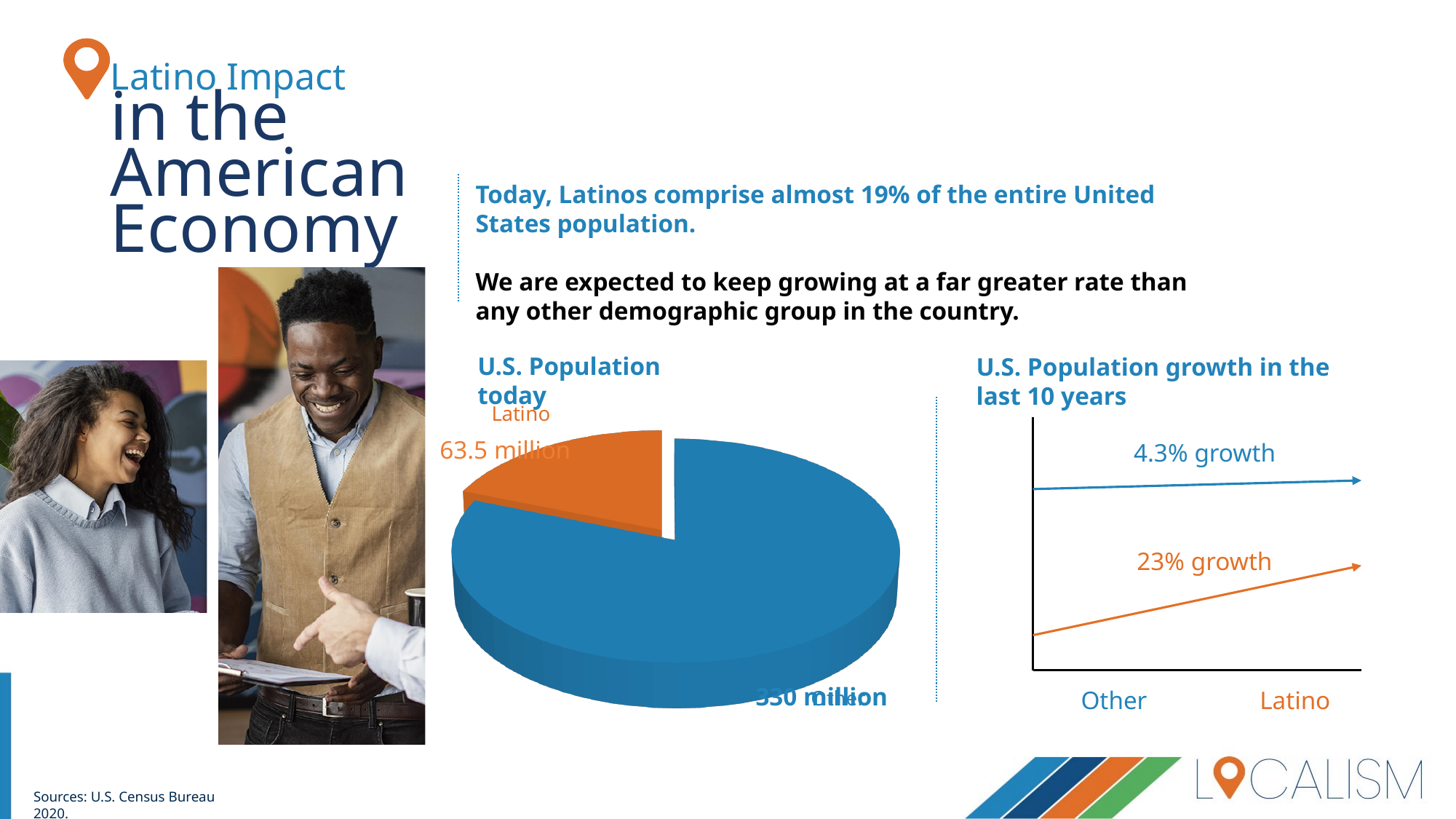
In the "U.S. Population growth in the last 10 years" chart, what growth is shown for Other? 4.3% growth In the "U.S. Population today" pie chart, which slice is the largest? Other How many lines are plotted in the "U.S. Population growth in the last 10 years" chart? 2 In the "U.S. Population today" pie chart, what value is shown for the blue slice? 330 million What kind of chart is the "U.S. Population today" chart? Pie chart In the "U.S. Population growth in the last 10 years" chart, what is the difference between the Latino growth rate and the Other growth rate? 18.7% How many slices does the "U.S. Population today" pie chart have? 2 In the "U.S. Population growth in the last 10 years" chart, what growth is shown for Latino? 23% growth In the "U.S. Population today" pie chart, what value is shown for Latino? 63.5 million In the "U.S. Population growth in the last 10 years" chart, which group has the higher growth rate, Latino or Other? Latino What kind of chart is the "U.S. Population growth in the last 10 years" chart? Line chart In the "U.S. Population today" pie chart, what colour is the Latino slice? Orange